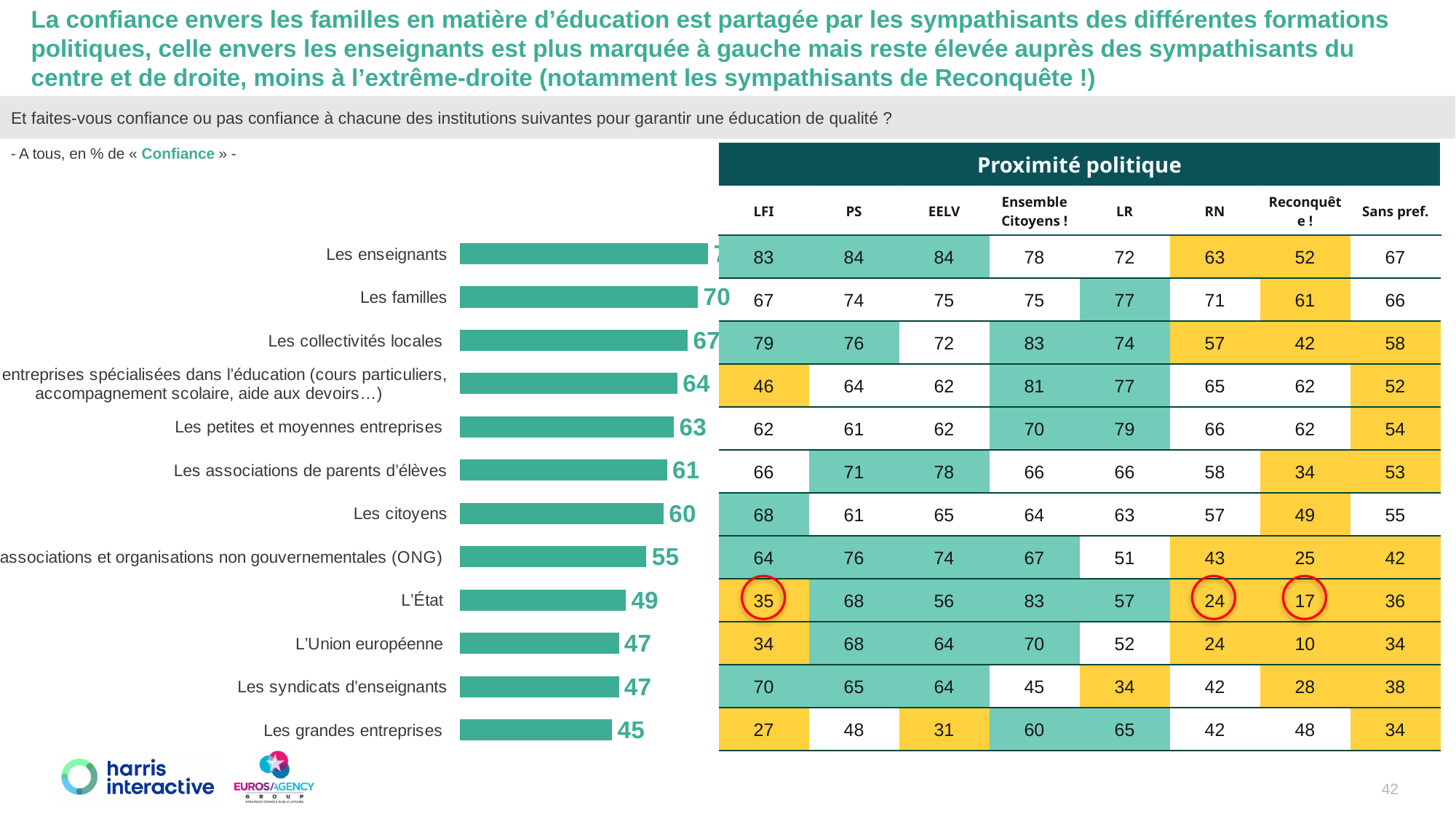
What kind of chart is shown on the slide? bar chart Which is larger, the value for Les petites et moyennes entreprises or the value for Les associations de parents d'élèves? Les petites et moyennes entreprises Which category has the highest value? Les enseignants What colour are the bars in the chart? green What is the value for Les collectivités locales? 67 What is the difference between the values for L'État and Les grandes entreprises? 4 Which category has the lowest value? Les grandes entreprises How many categories are shown in the bar chart? 12 What is the difference between the values for Les familles and Les citoyens? 10 What is the value for Les familles? 70 What is the value for Les grandes entreprises? 45 What is the value for L'État? 49